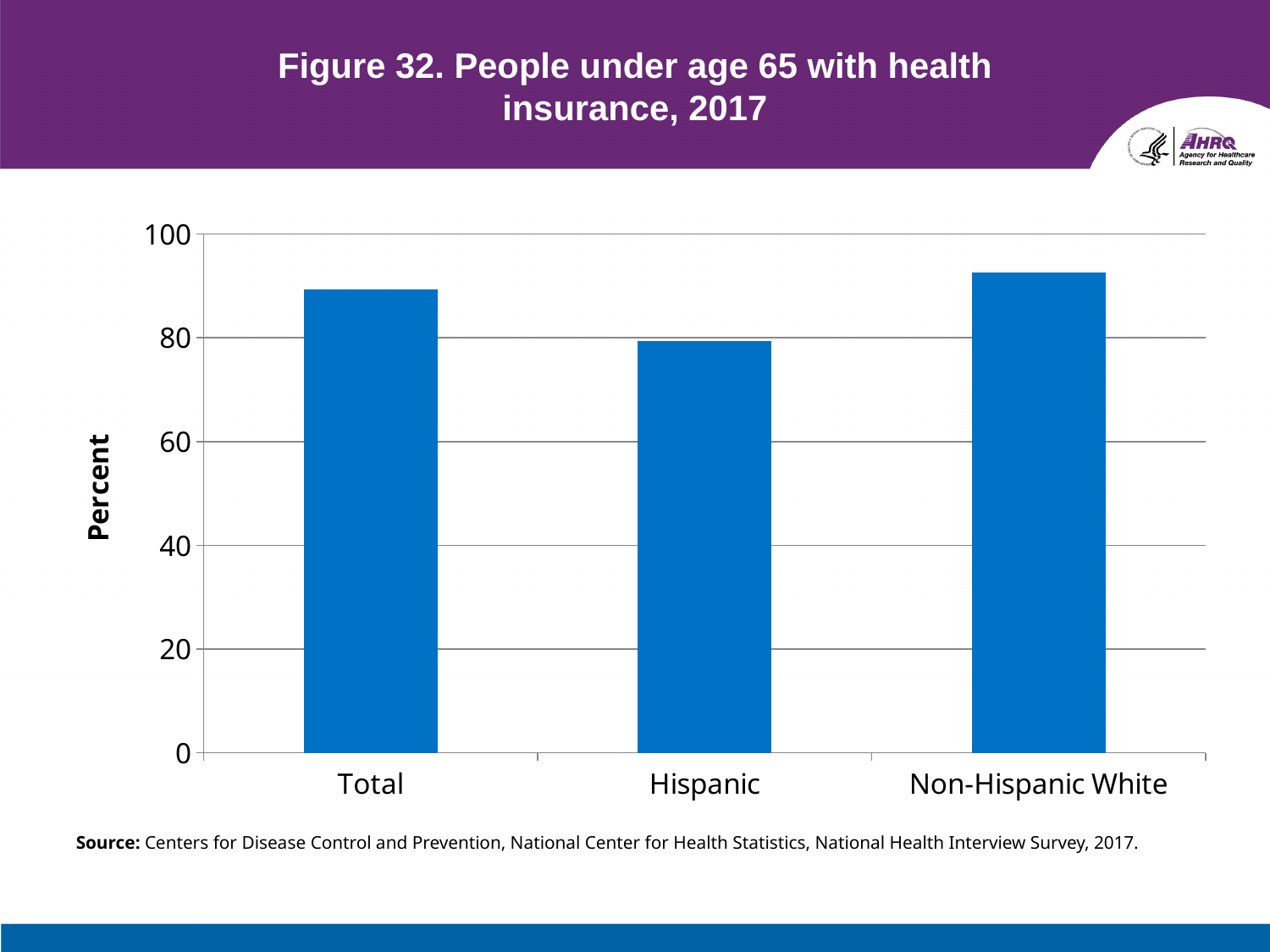
Which is larger, the value for Hispanic or the value for Non-Hispanic White? Non-Hispanic White What is the label on the y axis? Percent Is the value for Total greater or less than 80? greater Which category has the highest value? Non-Hispanic White How many categories are shown on the x axis? 3 What is the title of the chart? Figure 32. People under age 65 with health insurance, 2017 What is the highest value shown on the y axis? 100 What kind of chart is shown on the slide? bar chart Which category has the lowest value? Hispanic Which is larger, the value for Total or the value for Hispanic? Total